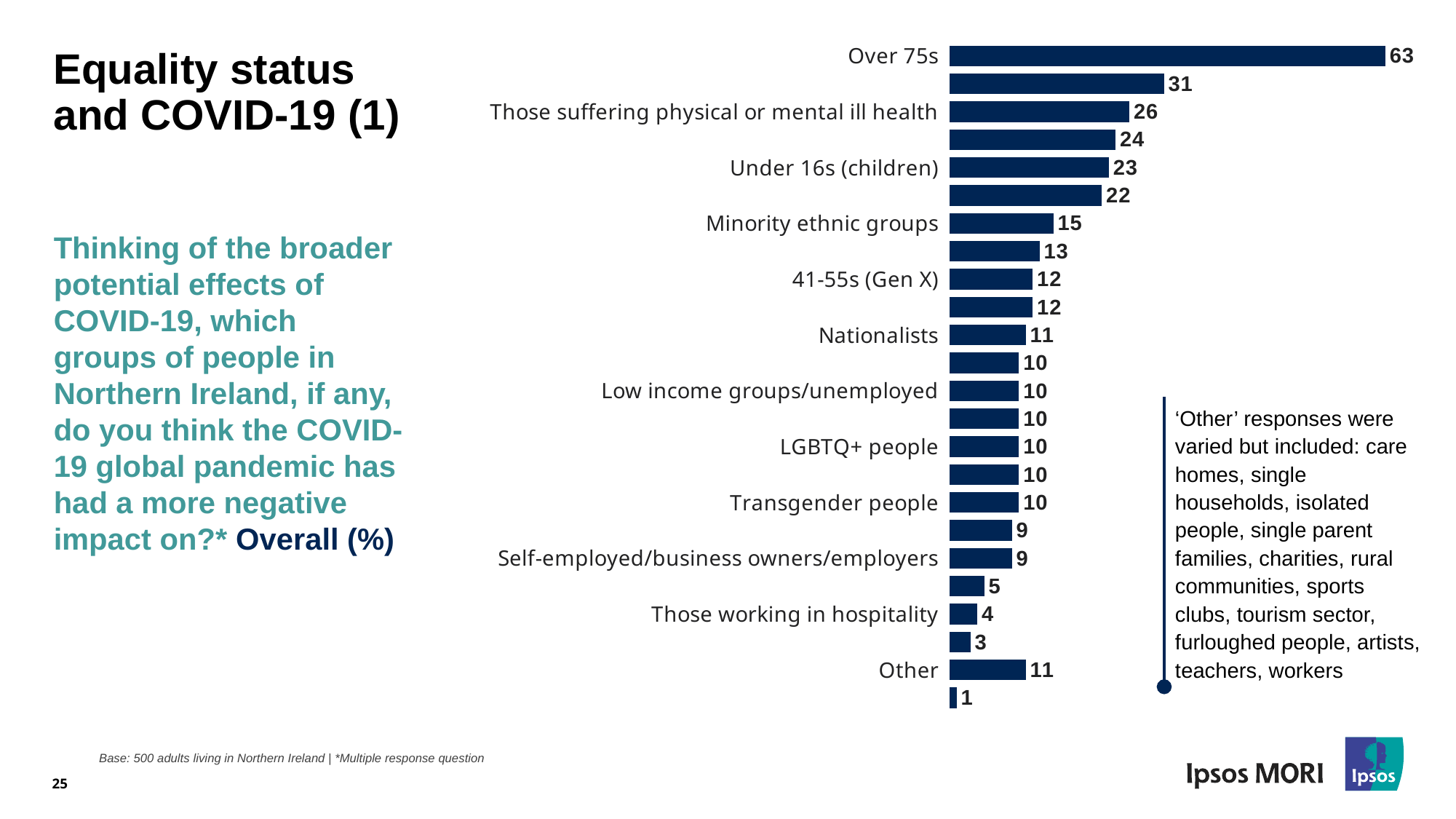
What percentage of respondents said the pandemic had a more negative impact on Over 75s? 63 What value is shown for 'Under 16s (children)'? 23 What kind of chart is shown on the slide? Bar chart How many bars are plotted in the chart? 24 What is the difference between the values for Over 75s and Under 16s (children)? 40 What is the smallest value shown on any bar in the chart? 1 Which has the larger value: Nationalists or Those working in hospitality? Nationalists What is the difference between the values for Minority ethnic groups and 41-55s (Gen X)? 3 What value is shown for 'Other'? 11 Which group has the highest value in the chart? Over 75s What value is shown for 'Minority ethnic groups'? 15 What value is shown for 'Those suffering physical or mental ill health'? 26